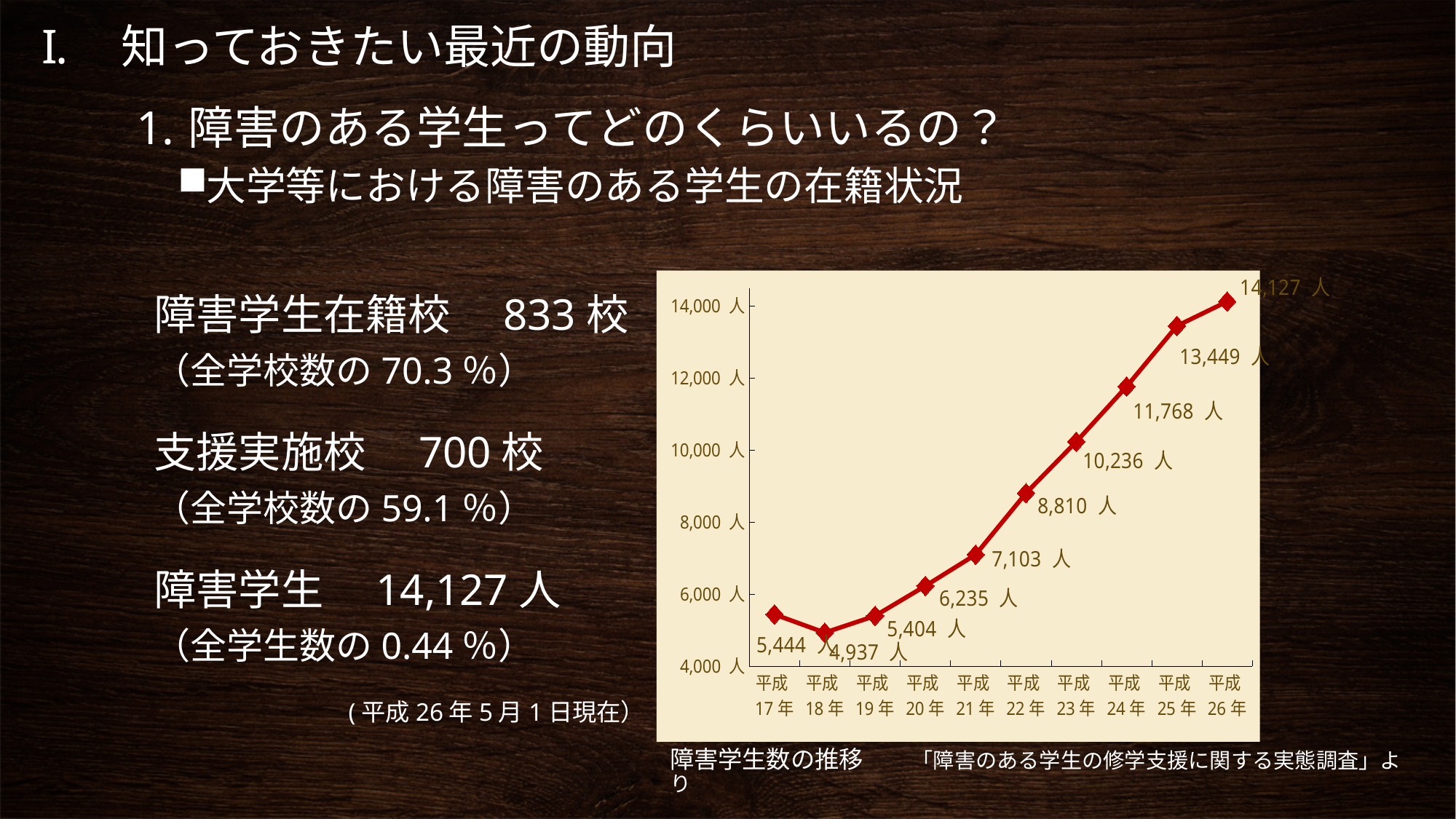
What is the difference between the values for 平成26年 and 平成25年? 678 人 What kind of chart is shown on the slide? line chart What is the difference between the values for 平成17年 and 平成18年? 507 人 Which is larger, the value for 平成17年 or the value for 平成19年? 平成17年 Is the value for 平成23年 greater or less than 10,000? greater What is the value for 平成26年 on the chart? 14,127 人 What is the value for 平成22年 on the chart? 8,810 人 What is the value for 平成18年 on the chart? 4,937 人 Which year has the lowest value on the chart? 平成18年 How many years are plotted on the chart? 10 From 平成18年 to 平成26年, do the values rise or fall? rise Which year has the highest value on the chart? 平成26年